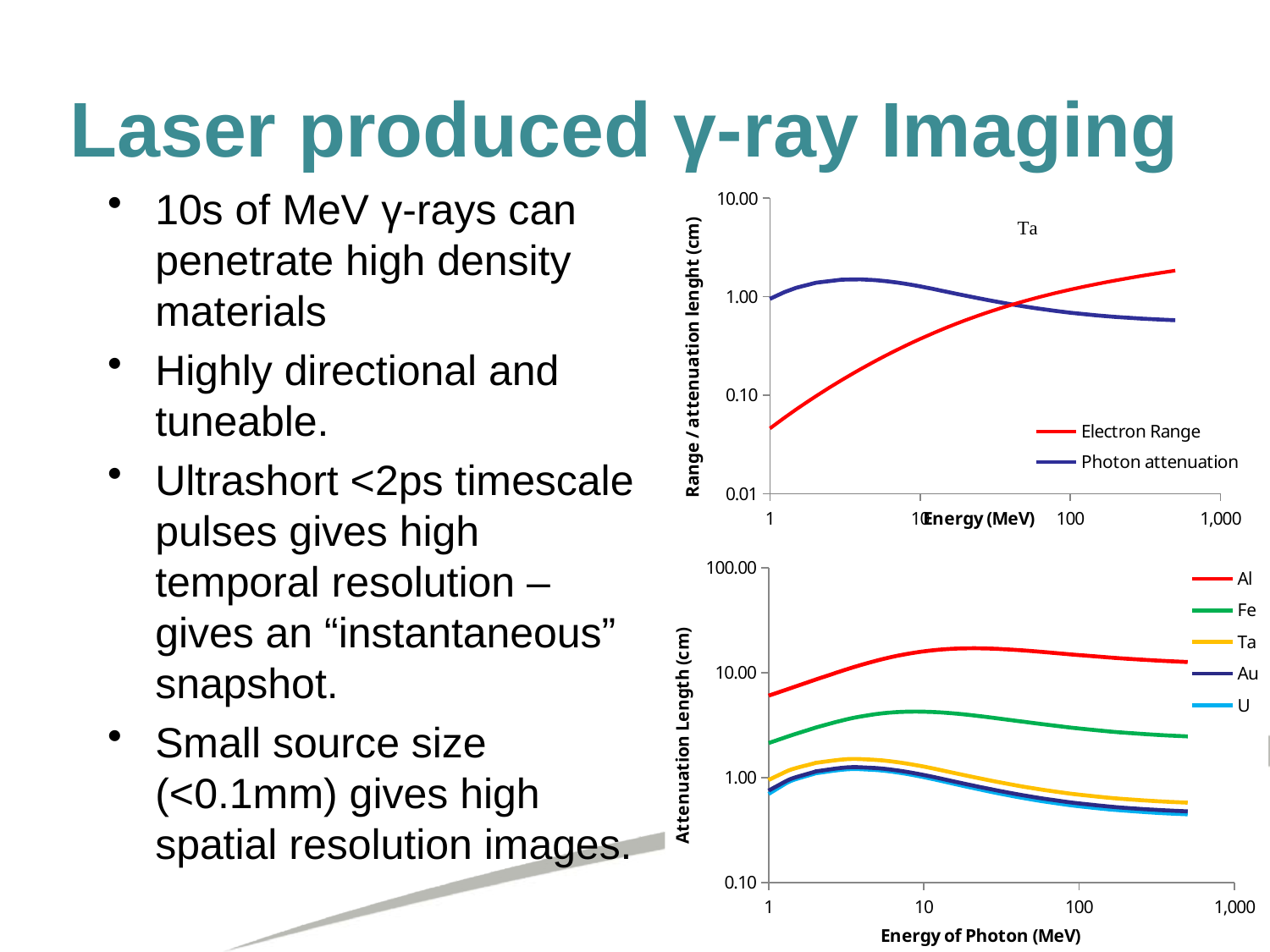
In the bottom chart, is the attenuation length for Fe at 1 MeV greater or less than 10.00? less In the bottom chart, which material has the highest attenuation length across the energy range? Al What is the x-axis title of the bottom chart? Energy of Photon (MeV) What kind of chart is the bottom chart? line chart How many series does the legend of the top chart list? 2 In the top chart, is the Electron Range value at its right-hand end greater or less than 1.00? greater In the bottom chart, which has the larger attenuation length at 100 MeV, Al or Ta? Al In the bottom chart, is the attenuation length for Al at 10 MeV greater or less than 10.00? greater In the top chart, does the Electron Range series rise or fall as energy increases along the x axis? rises How many series does the legend of the bottom chart list? 5 In the top chart, what colour is the Electron Range line? red